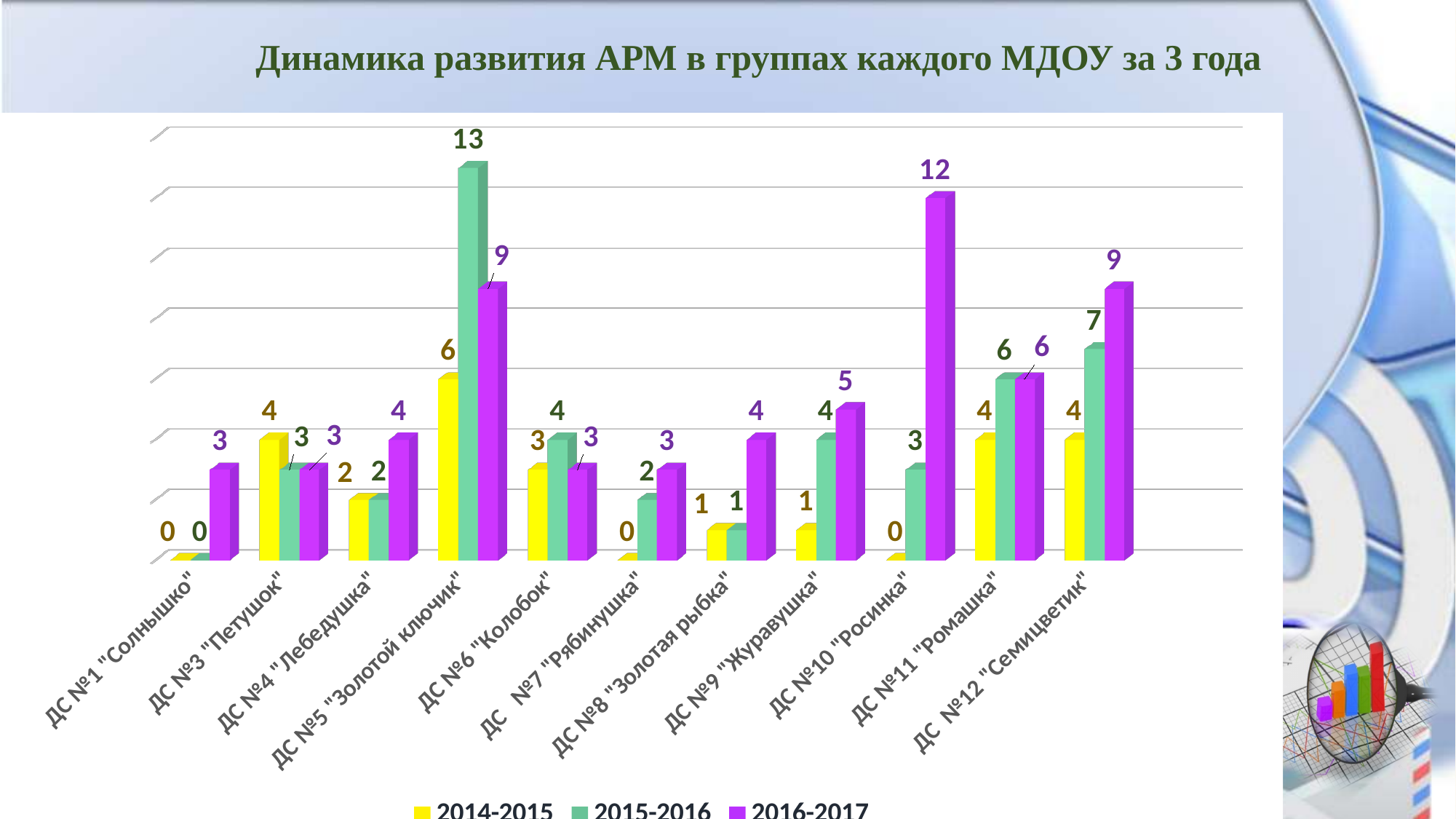
Which is larger for ДС №12 "Семицветик": the 2015-2016 value or the 2016-2017 value? 2016-2017 What is the value for ДС №5 "Золотой ключик" in 2015-2016? 13 What is the value for ДС №10 "Росинка" in 2016-2017? 12 What is the difference between the 2015-2016 and 2016-2017 values for ДС №5 "Золотой ключик"? 4 Do the values for ДС №9 "Журавушка" rise or fall from 2014-2015 to 2016-2017? rise Which kindergarten has the highest value in the 2016-2017 series? ДС №10 "Росинка" Which colour represents the 2014-2015 series in the legend? yellow What type of chart is shown on the slide? bar chart What is the value for ДС №11 "Ромашка" in 2014-2015? 4 How many kindergartens (categories) are shown on the x axis? 11 How many series does the legend list? 3